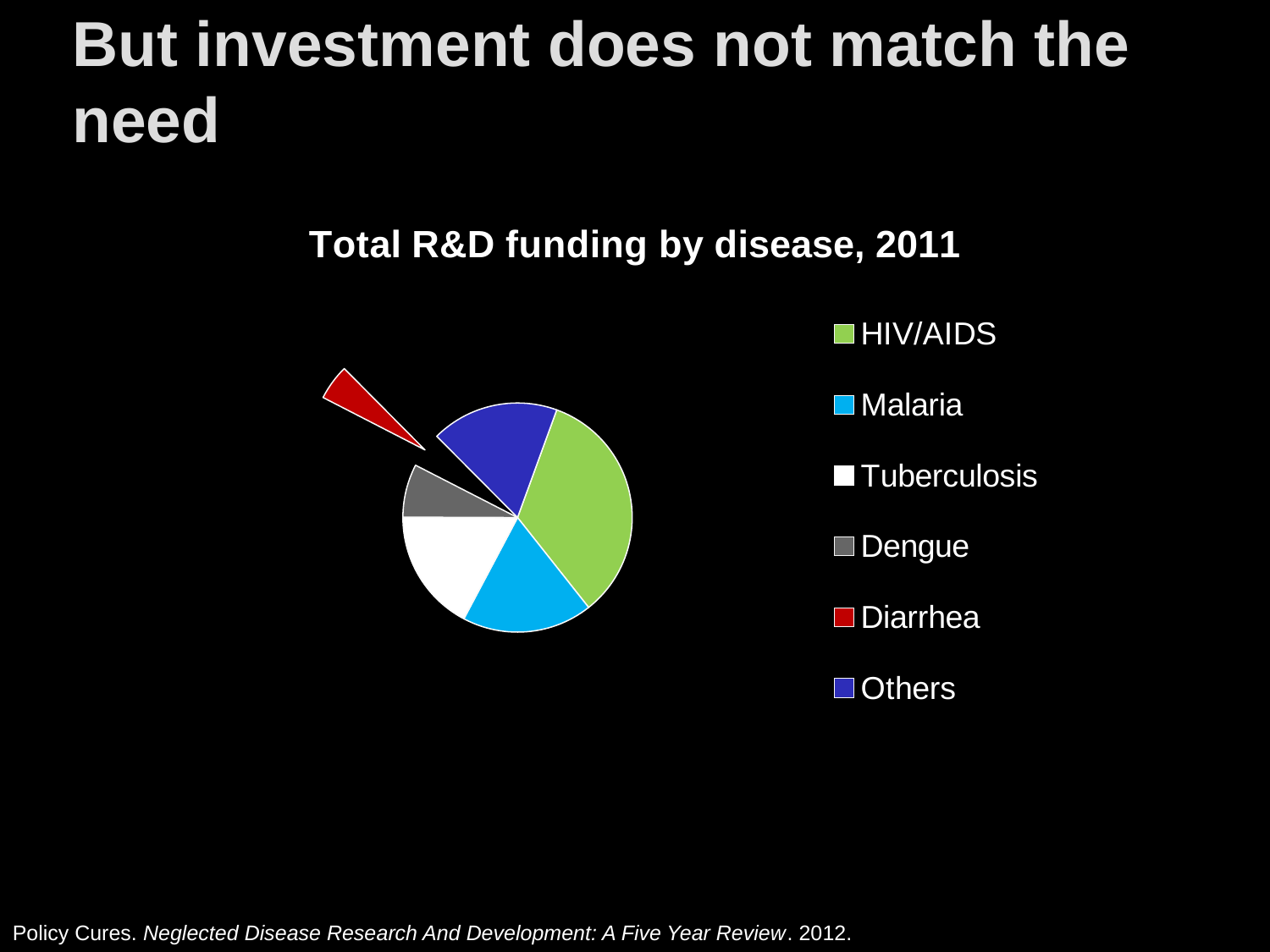
Which disease category has the smallest share of R&D funding in the pie chart? Diarrhea What kind of chart is shown on the slide? Pie chart Which slice is larger, Others or Diarrhea? Others How many disease categories does the pie chart show? 6 Which slice is larger, HIV/AIDS or Others? HIV/AIDS Which slice is larger, Tuberculosis or Dengue? Tuberculosis Which disease category has the largest share of R&D funding in the pie chart? HIV/AIDS Which slice is pulled out (exploded) from the rest of the pie? Diarrhea What is the title of the chart? Total R&D funding by disease, 2011